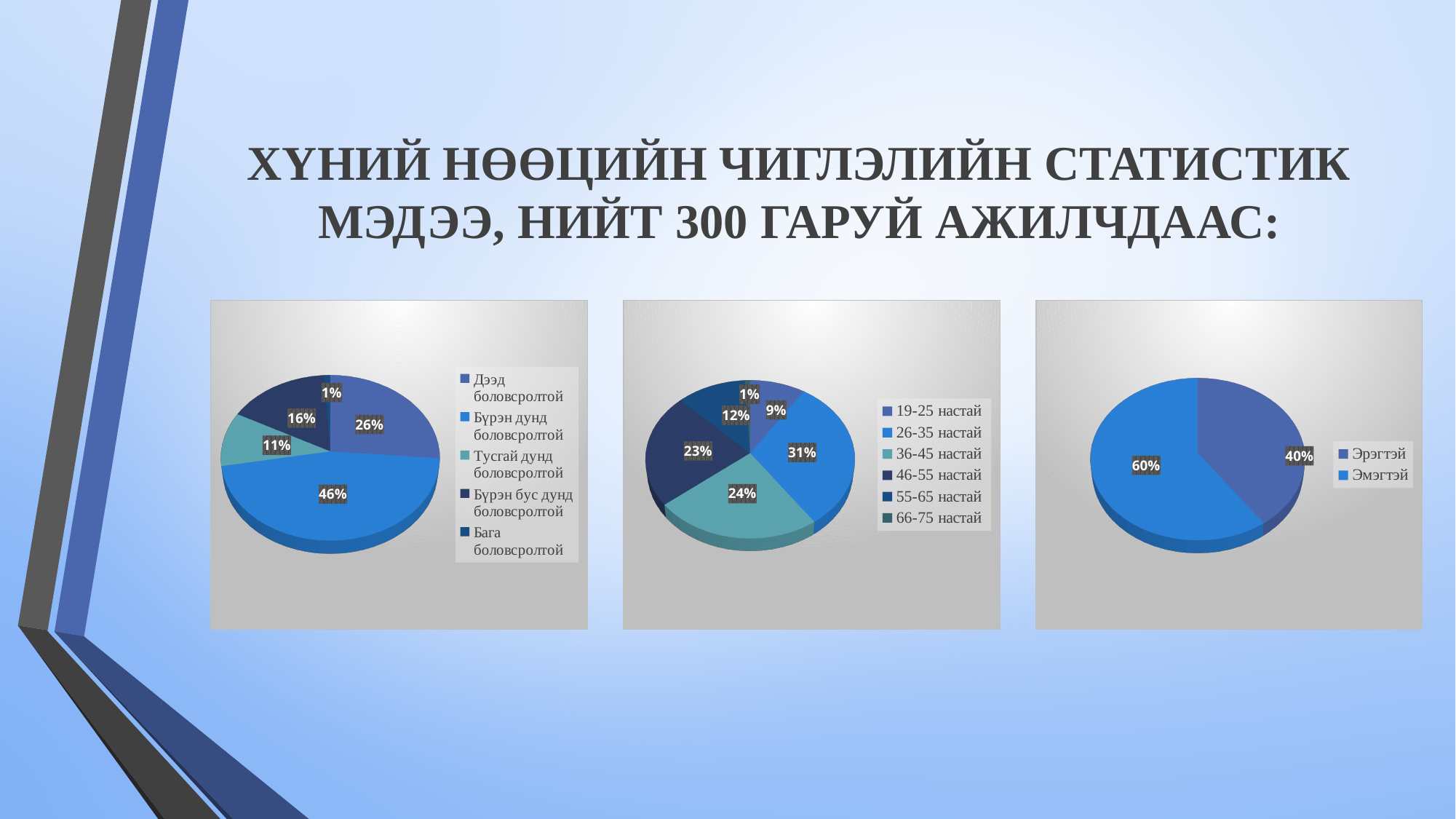
On the left pie chart, which category has the smallest share? Бага боловсролтой How many age groups does the legend of the middle pie chart list? 6 On the middle pie chart, what share is labelled for 36-45 настай? 24% On the middle pie chart, what is the combined share of 46-55 настай and 55-65 настай? 35% On the middle pie chart, which is larger: the share for 19-25 настай or the share for 55-65 настай? 55-65 настай On the left pie chart, what is the difference between the shares for Дээд боловсролтой and Бүрэн бус дунд боловсролтой? 10% On the right pie chart, what is the difference between the shares for Эмэгтэй and Эрэгтэй? 20% What type of chart is the right chart on the slide? Pie chart How many categories does the legend of the left pie chart list? 5 On the left pie chart, what share is labelled for Бүрэн дунд боловсролтой? 46% On the middle pie chart, which age group has the largest share? 26-35 настай On the right pie chart, what share is labelled for Эмэгтэй? 60%